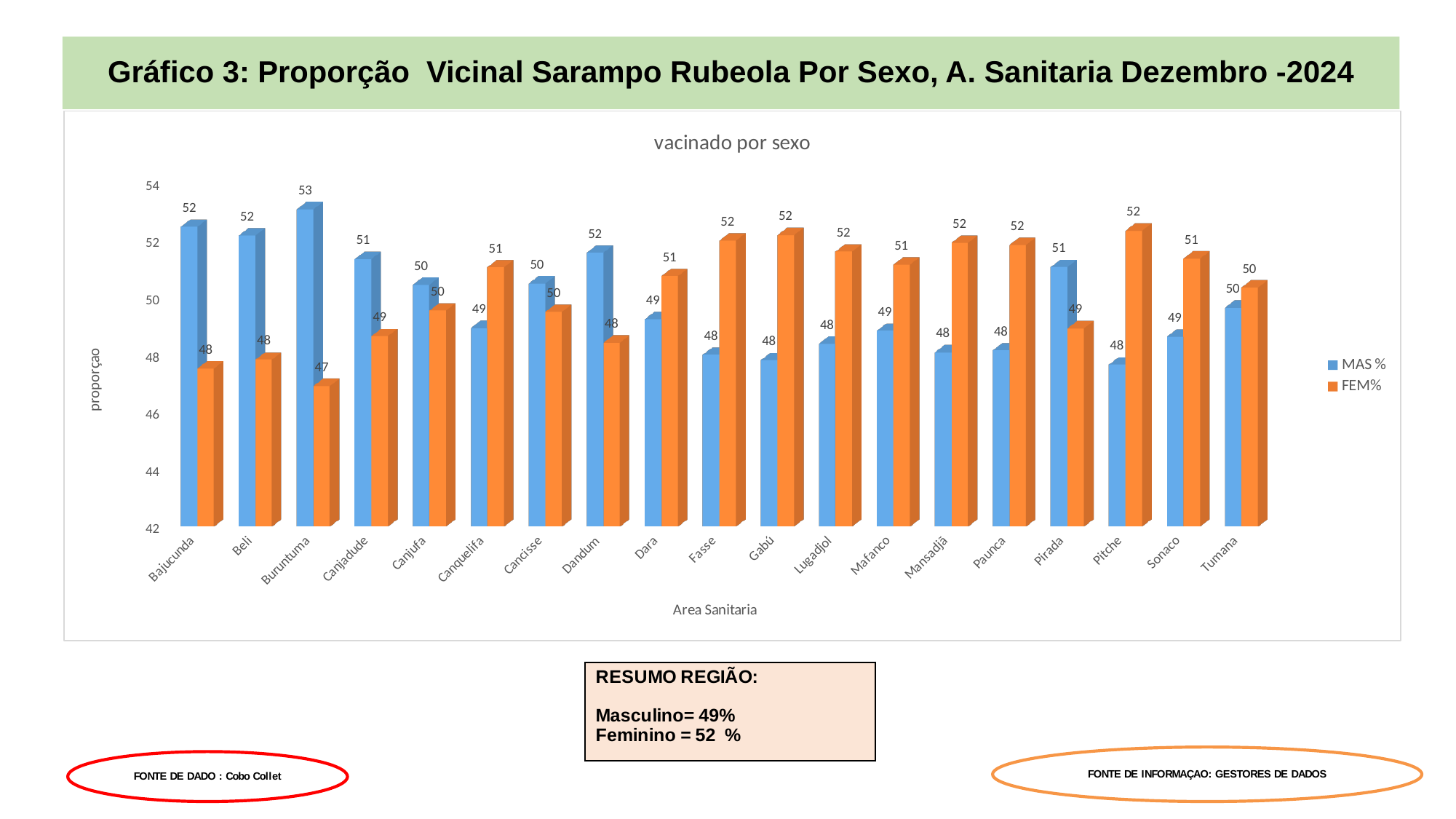
Which health area has the highest MAS % value? Buruntuma What is the MAS % value for Pitche? 48 How many series does the legend list? 2 What is the difference between the FEM% values for Pitche and Bajucunda? 4 What is the FEM% value for Gabú? 52 Which health area has the lowest FEM% value? Buruntuma What is the MAS % value for Buruntuma? 53 For Fasse, which is larger, MAS % or FEM%? FEM% What is the difference between the MAS % and FEM% values for Buruntuma? 6 How many health areas (categories) are shown on the x axis? 19 What type of chart is shown on the slide? bar chart What is the title shown above the plot area of the chart? vacinado por sexo